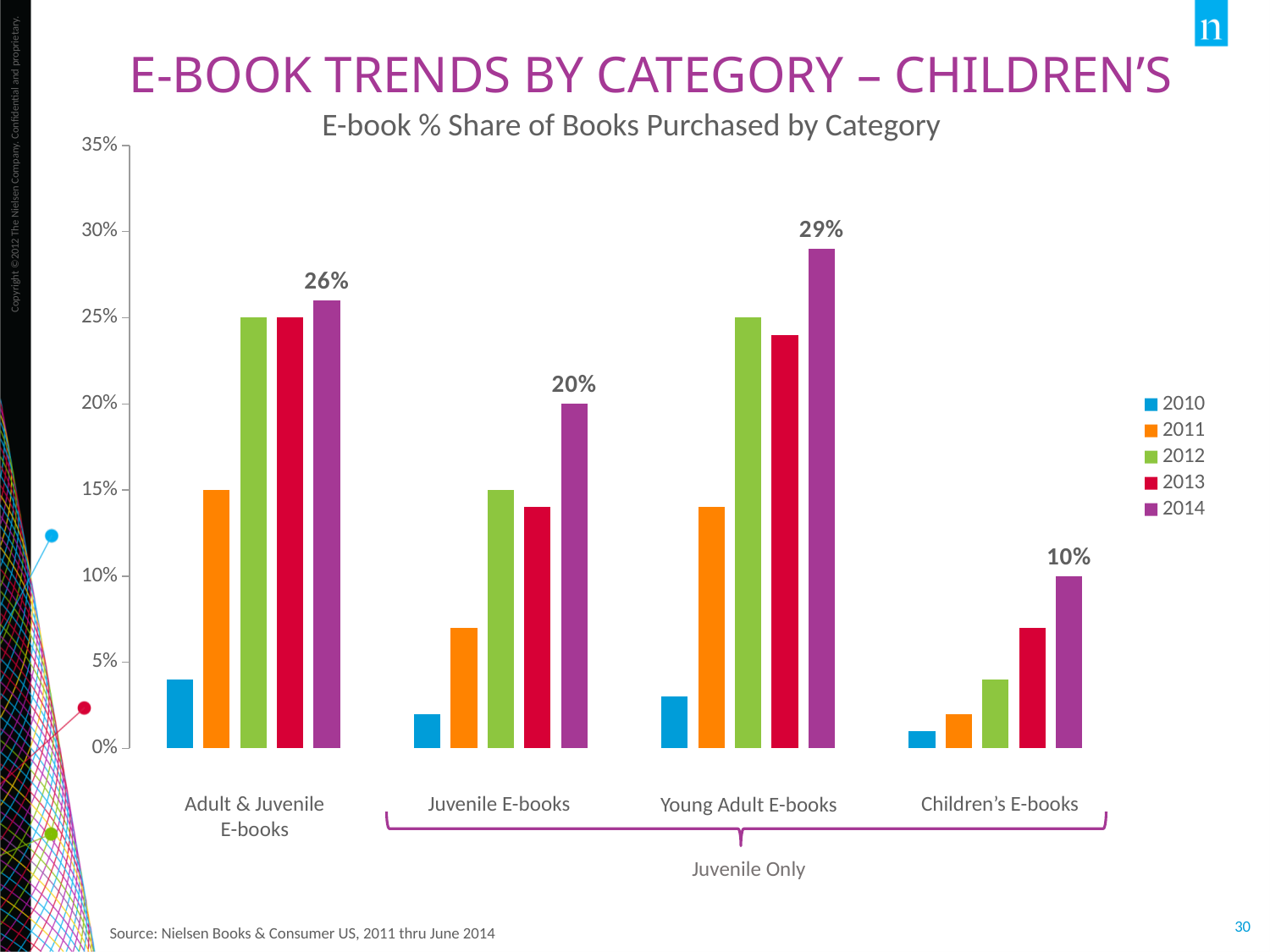
Which is larger in 2014: the share for Adult & Juvenile E-books or for Juvenile E-books? Adult & Juvenile E-books How many categories are shown on the x axis? 4 What is the 2014 e-book share for Young Adult E-books? 29% Which category has the highest 2014 e-book share? Young Adult E-books What is the 2014 e-book share for Adult & Juvenile E-books? 26% How many series does the legend list? 5 Do the values for Children's E-books rise or fall from 2010 to 2014? rise Is the 2010 value for Adult & Juvenile E-books greater or less than 5%? less Which category has the lowest 2014 e-book share? Children's E-books What is the 2014 e-book share for Juvenile E-books? 20% What is the difference between the 2014 shares for Young Adult E-books and Children's E-books? 19 percentage points What is the 2014 e-book share for Children's E-books? 10%